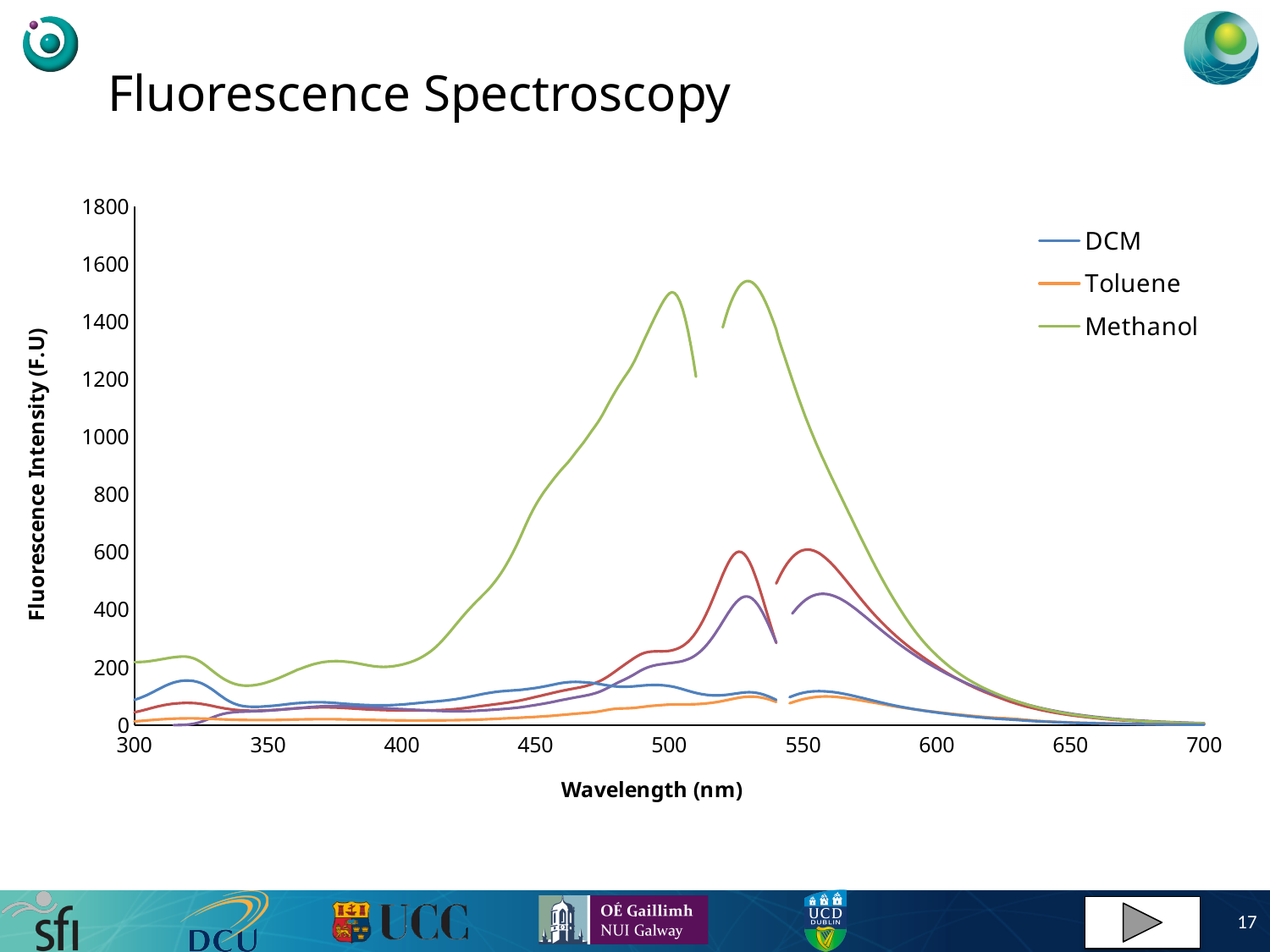
What is the title of the x axis? Wavelength (nm) At 450 nm, which series has the larger value, Methanol or DCM? Methanol At 320 nm, which series has the larger value, DCM or Toluene? DCM Is the value of the DCM series at 500 nm greater or less than 200? less Is the peak value of the Methanol series greater or less than 1400? greater How many series does the legend list? 3 What is the title of the y axis? Fluorescence Intensity (F.U) Is the value of the Methanol series at 400 nm greater or less than 400? less What kind of chart is shown on the slide? line chart Does the Methanol series rise or fall between 600 nm and 700 nm? fall Which legend series reaches the highest fluorescence intensity? Methanol